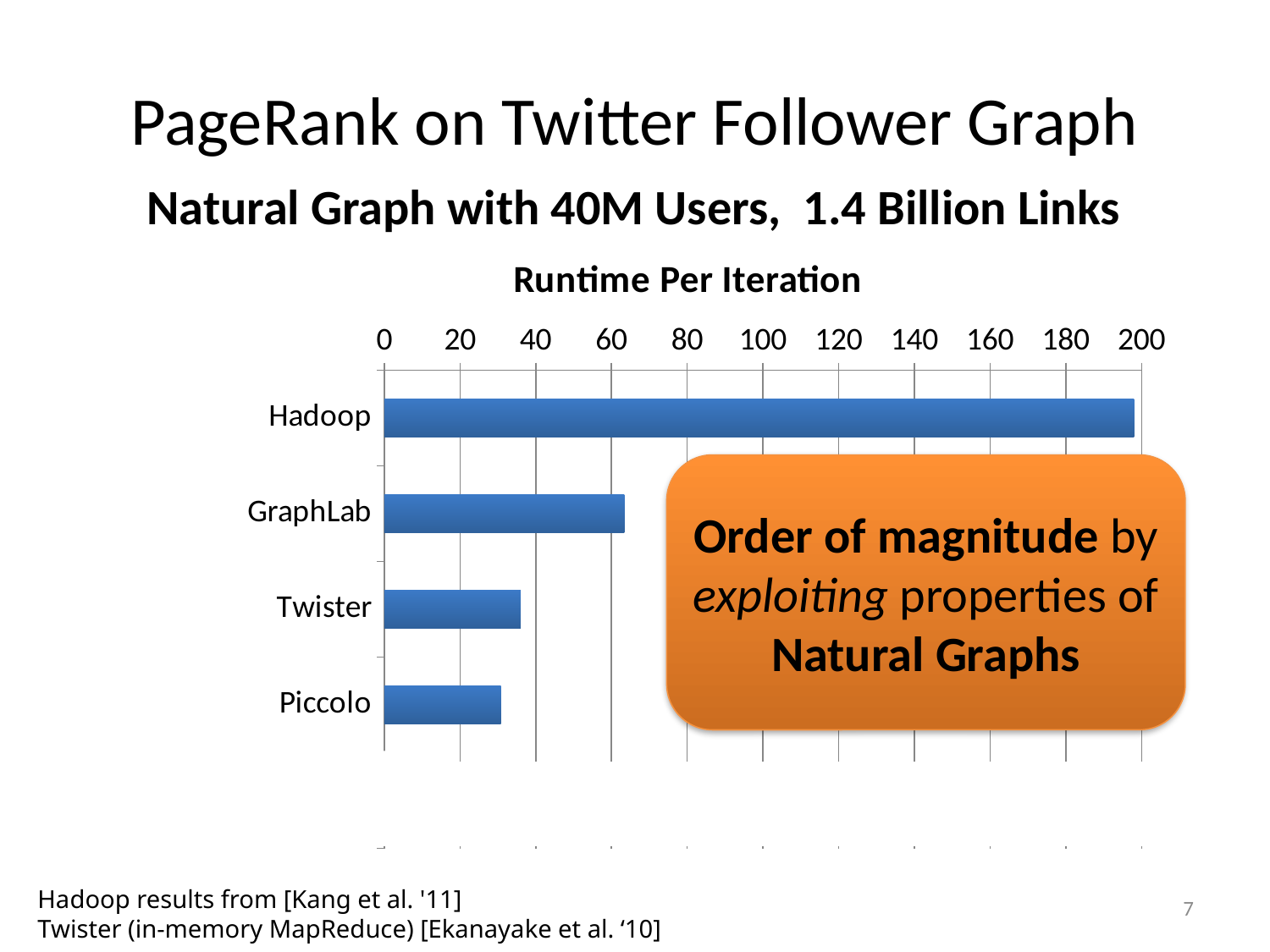
Is the value for GraphLab greater or less than 80? less What is the maximum value shown on the chart's horizontal axis? 200 What is the title of the chart? Runtime Per Iteration How many systems (categories) are plotted in the chart? 4 Which has a larger runtime per iteration, GraphLab or Piccolo? GraphLab Is the value for Twister greater or less than 40? less What kind of chart is shown on the slide? bar chart Which system has the highest runtime per iteration? Hadoop Which has a larger runtime per iteration, Hadoop or GraphLab? Hadoop Is the value for Hadoop greater or less than 180? greater